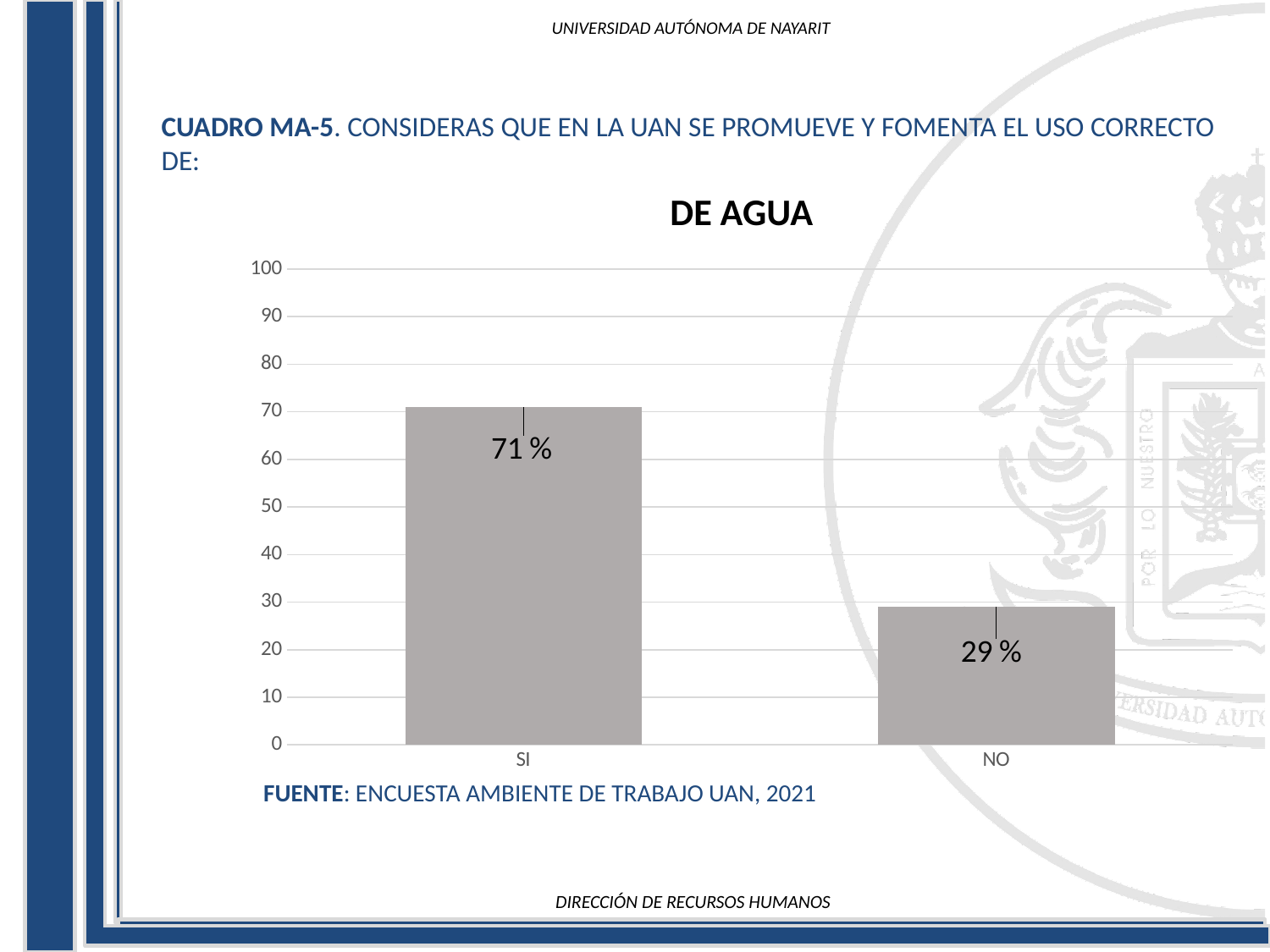
What is the value for NO? 29 % Is the value for SI greater or less than 50? greater Which is larger, the value for SI or the value for NO? SI Which category has the highest value? SI What is the title of the chart? DE AGUA Which category has the lowest value? NO What is the difference between the values for SI and NO? 42 % What is the highest value shown on the y axis? 100 What is the value for SI? 71 % How many categories are shown on the x axis? 2 Is the value for NO greater or less than 40? less What kind of chart is shown on the slide? bar chart